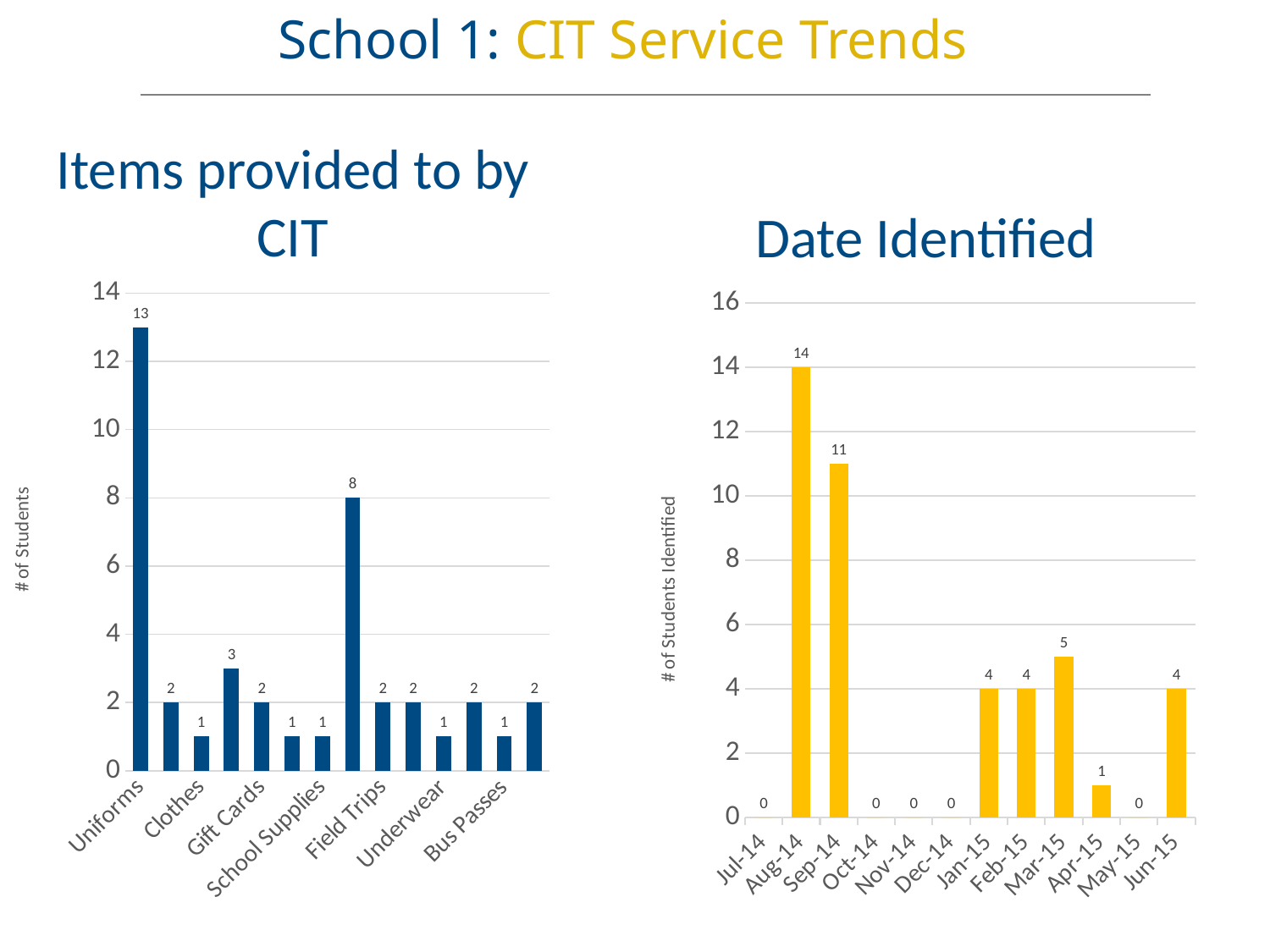
In the 'Items provided to by CIT' chart, what is the value for Gift Cards? 2 In the 'Date Identified' chart, how many students were identified in Aug-14? 14 In the 'Date Identified' chart, which month has the highest number of students identified? Aug-14 In the 'Date Identified' chart, what is the value for Mar-15? 5 In the 'Date Identified' chart, what is the difference between the values for Aug-14 and Sep-14? 3 In the 'Items provided to by CIT' chart, what is the difference between the values for Uniforms and Field Trips? 11 In the 'Items provided to by CIT' chart, how many students received Uniforms? 13 What is the y-axis label of the 'Date Identified' chart? # of Students Identified What kind of chart is the 'Date Identified' chart? Bar chart In the 'Items provided to by CIT' chart, which is larger, the value for Uniforms or the value for Underwear? Uniforms In the 'Items provided to by CIT' chart, which labeled item has the highest value? Uniforms In the 'Date Identified' chart, how many months are shown on the x axis? 12